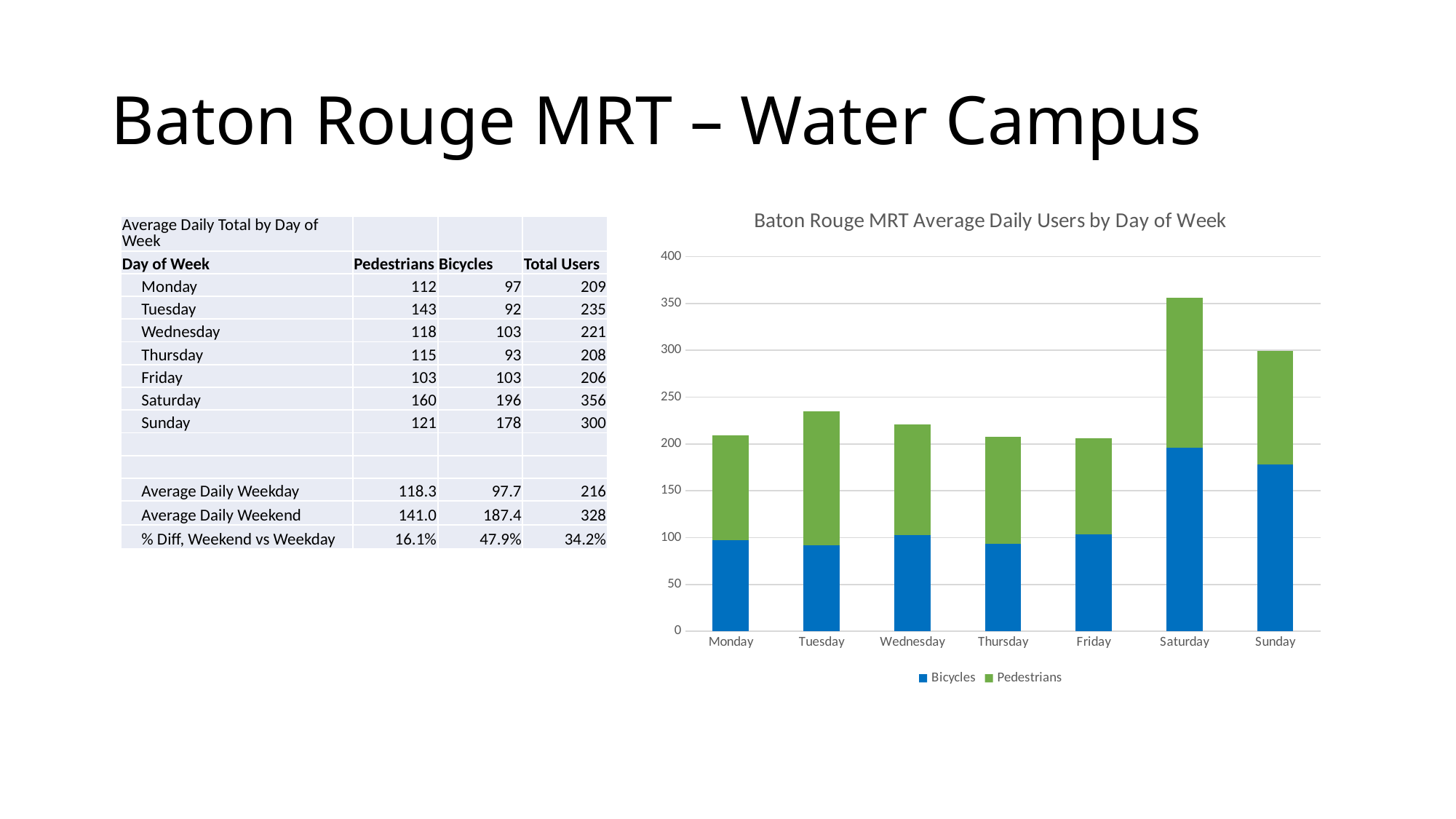
Which day has the shortest stacked bar in the chart? Friday How many days of the week are plotted on the x axis of the chart? 7 Which is larger, the Bicycles value for Saturday or the Bicycles value for Sunday? Saturday How many series does the chart legend list? 2 Is the Bicycles value for Tuesday greater or less than 100? less Which colour represents Pedestrians in the chart? green What is the title of the chart? Baton Rouge MRT Average Daily Users by Day of Week According to the slide, what is the total users value for Saturday? 356 What kind of chart is shown on the slide? bar chart Is the total stacked bar for Sunday greater or less than 250? greater Is the total stacked bar for Saturday greater or less than 350? greater Which day has the tallest stacked bar in the chart? Saturday